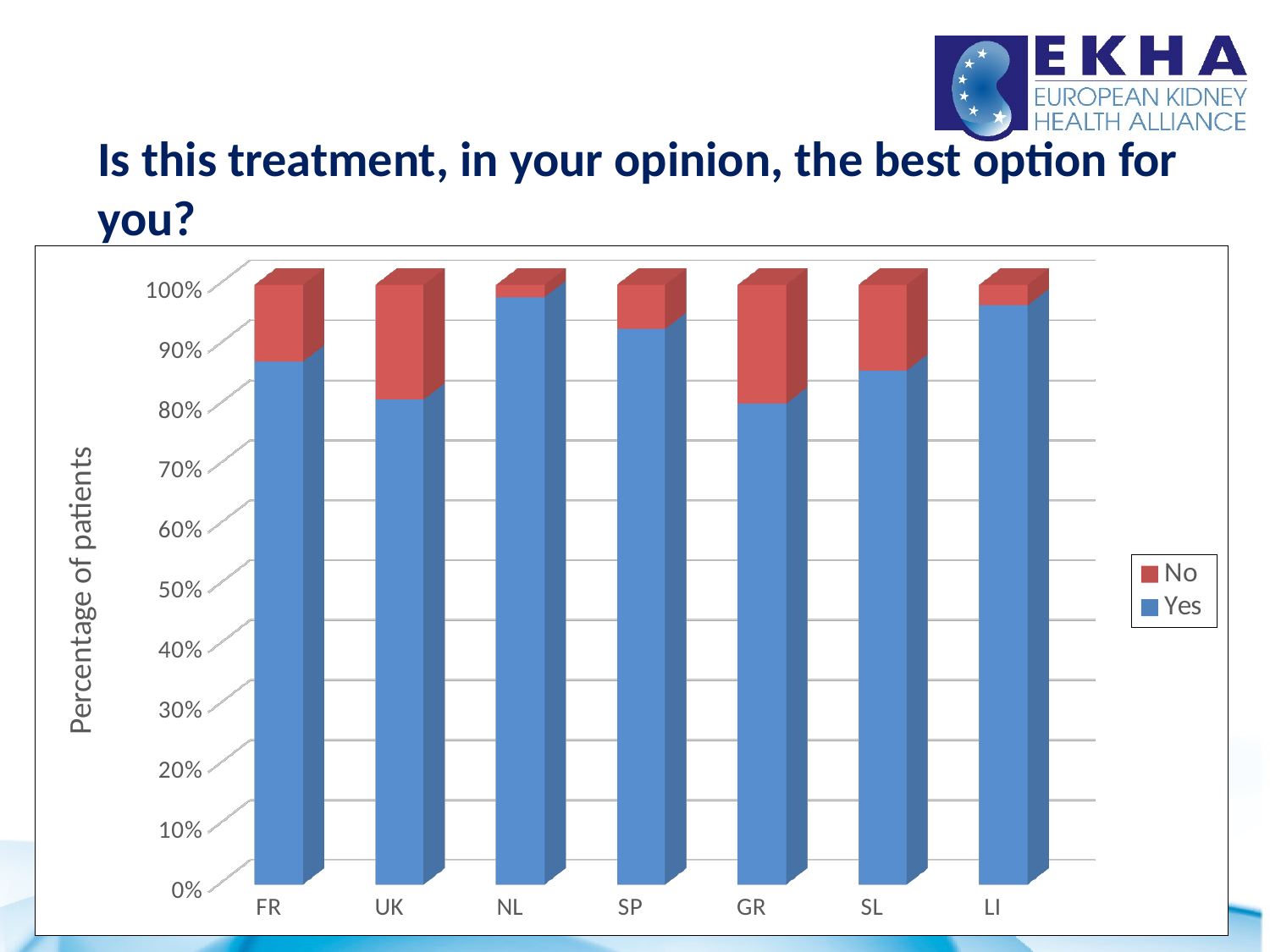
Which has a larger 'Yes' share, FR or UK? FR Is the 'Yes' value for GR greater or less than 90%? less What kind of chart is shown on the slide? Stacked bar chart Is the 'Yes' value for NL greater or less than 90%? greater Is the 'Yes' value for FR greater or less than 80%? greater Which has a larger 'No' share, GR or NL? GR How many countries are shown on the x axis of the chart? 7 What is the total of the stacked bar for FR? 100% What is the label of the vertical axis? Percentage of patients Which colour represents the 'No' series in the chart? Red How many series does the chart legend list? 2